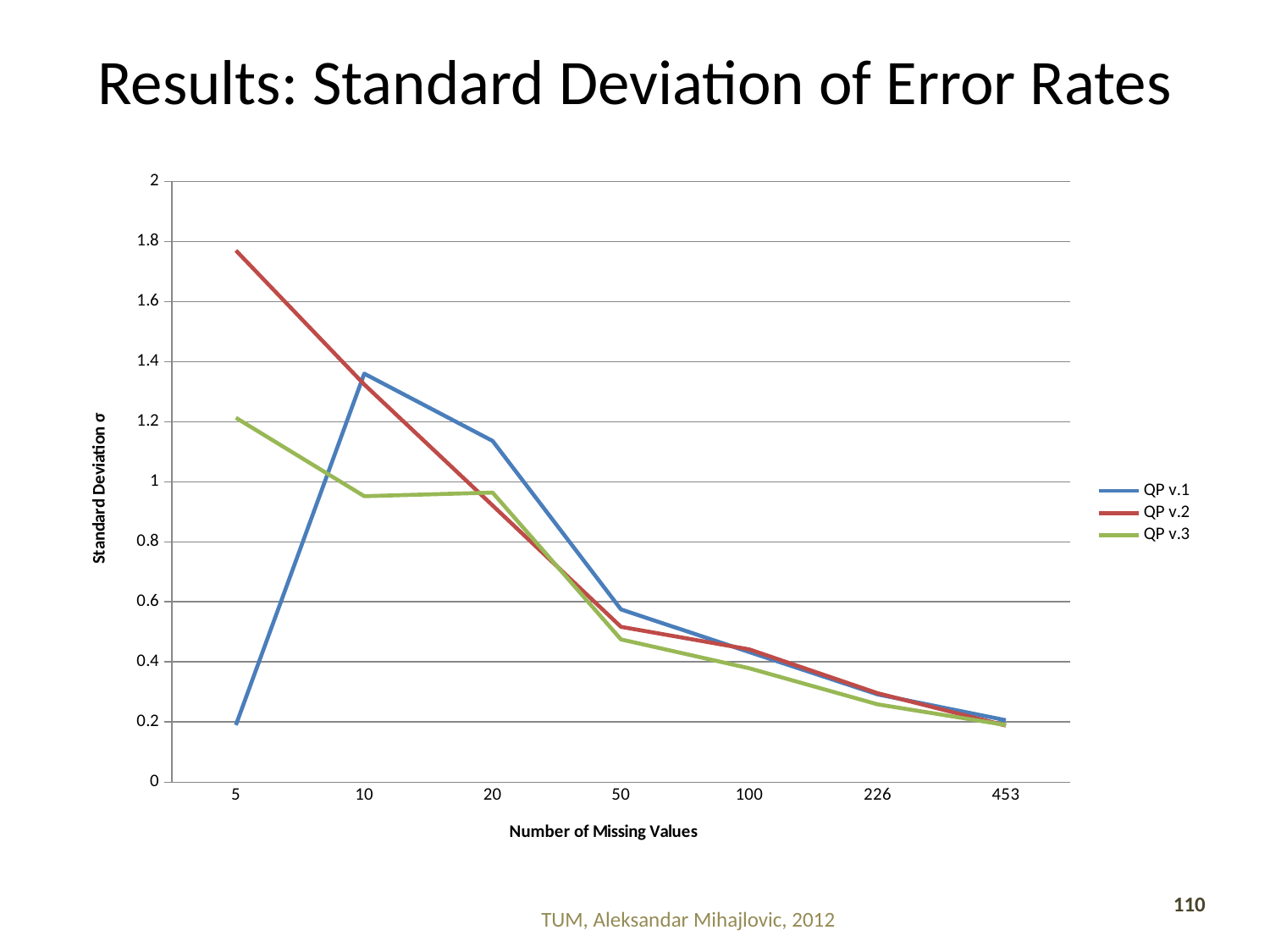
Which series has the highest standard deviation at 5 missing values? QP v.2 How many points are on the x axis (Number of Missing Values)? 7 What kind of chart is shown on the slide? line chart Is the value for QP v.2 at 5 missing values greater or less than 1.6? greater Is the value for QP v.3 at 10 missing values greater or less than 1? less At 10 missing values, which is larger: QP v.1 or QP v.3? QP v.1 Does the QP v.2 line rise or fall as the number of missing values increases from 5 to 453? fall What is the title of the x axis? Number of Missing Values How many series does the legend list? 3 At which number of missing values does QP v.1 reach its highest standard deviation? 10 Which series has the lowest standard deviation at 5 missing values? QP v.1 Is the value for QP v.1 at 5 missing values greater or less than 0.4? less